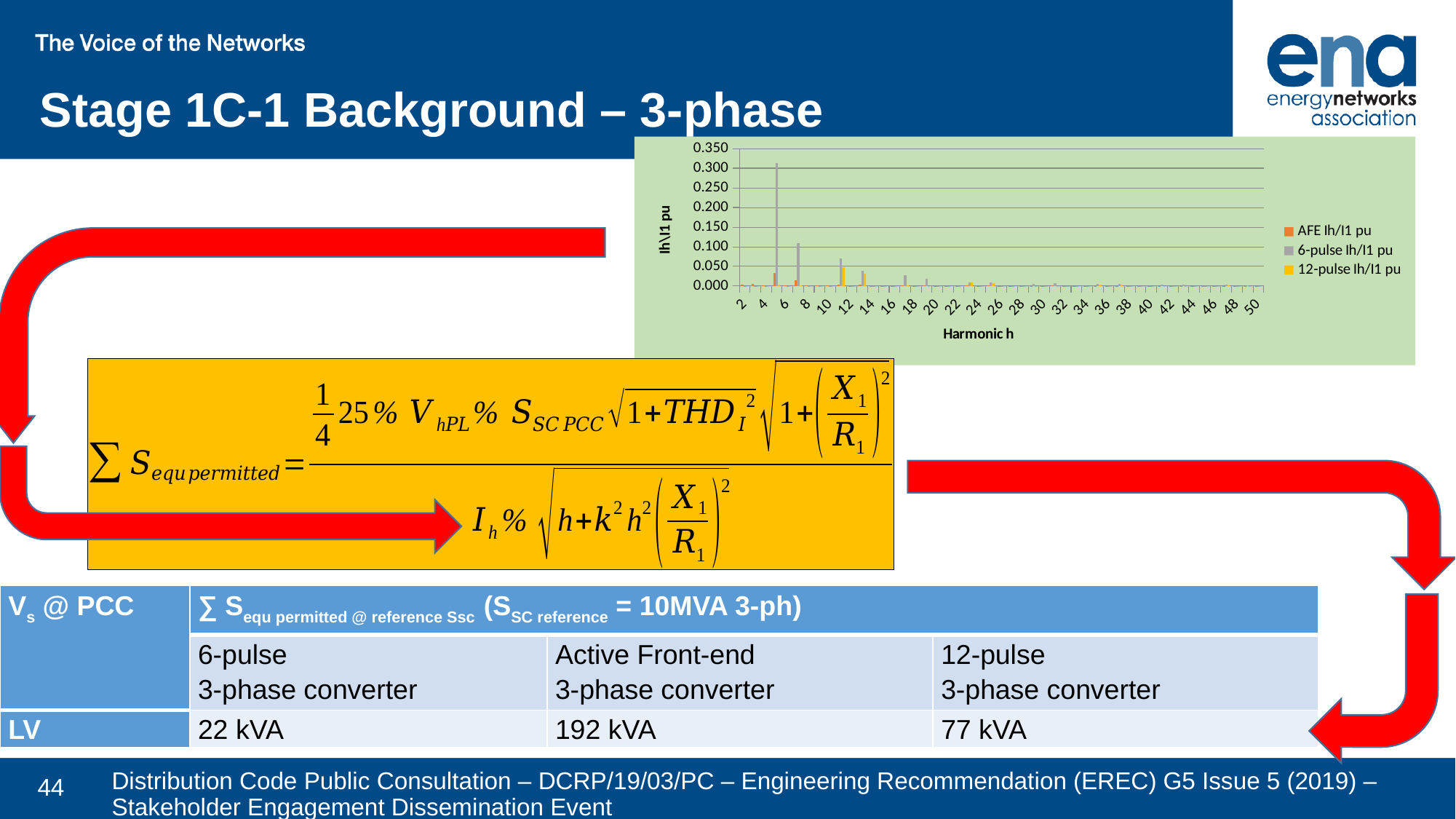
What is the highest value shown on the chart's y axis? 0.350 Is the value for AFE Ih/I1 pu at harmonic 2 greater or less than 0.050? less How many series does the chart legend list? 3 Is the tallest bar in the chart greater or less than 0.350? less Is the value for 12-pulse Ih/I1 pu at harmonic 50 greater or less than 0.050? less Do the 6-pulse Ih/I1 pu values generally rise or fall as the harmonic number increases along the x axis? fall What is the title of the chart's x axis? Harmonic h What is the title of the chart's y axis? Ih\I1 pu Which series has the tallest bar in the chart? 6-pulse Ih/I1 pu What kind of chart is shown on the slide? bar chart